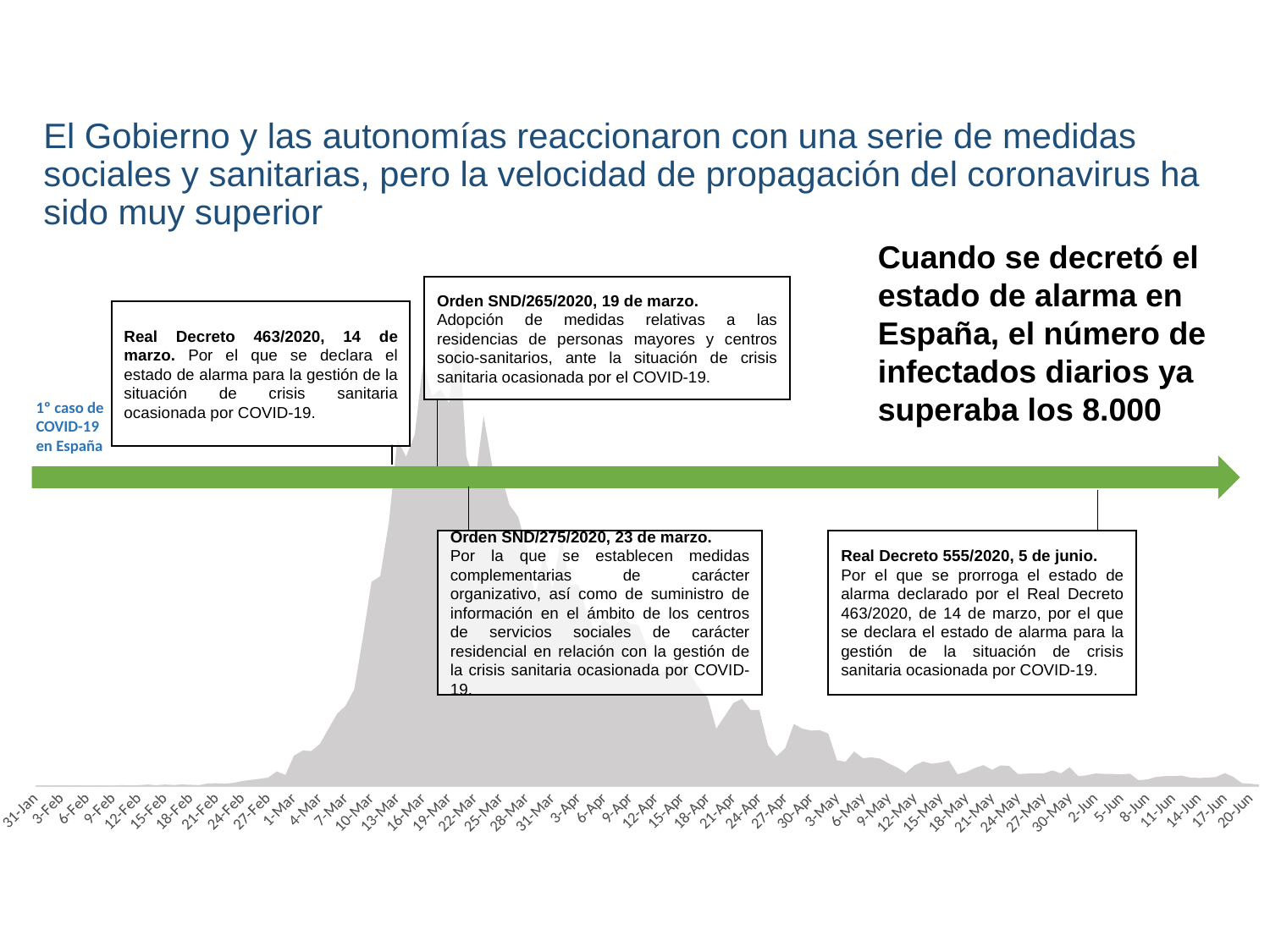
Do the values rise or fall along the x axis from 31-Jan to mid-March? rise Is the value at the start of the chart (31-Jan) higher or lower than the value at the peak in March? lower In which month does the chart reach its highest value? March Do the values rise or fall along the x axis from mid-April to 20-Jun? fall What is the last date label on the x axis of the chart? 20-Jun What is the first date label on the x axis of the chart? 31-Jan Which is larger, the value around 22-Mar or the value around 20-Jun? 22-Mar What kind of chart is shown on the slide? area chart Which is larger, the value around 1-Mar or the value around 1-Apr? 1-Apr